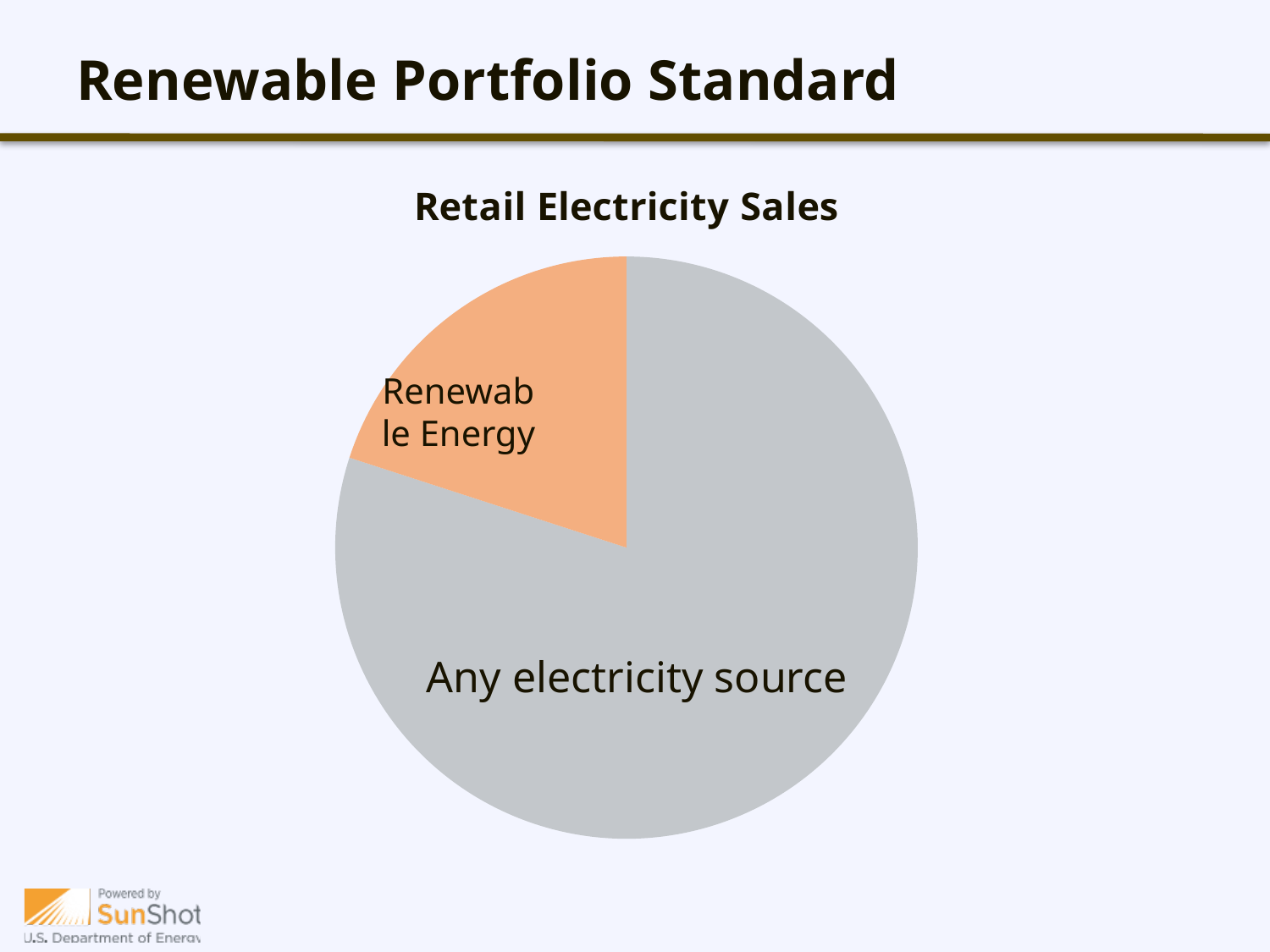
Which slice of the pie chart is the largest? Any electricity source Is the Renewable Energy slice more or less than half of the pie? less What colour is the Renewable Energy slice? orange What is the title of the chart? Retail Electricity Sales Which slice of the pie chart is the smallest? Renewable Energy Which slice is larger, Renewable Energy or Any electricity source? Any electricity source What kind of chart is shown on the slide? pie chart How many slices does the pie chart have? 2